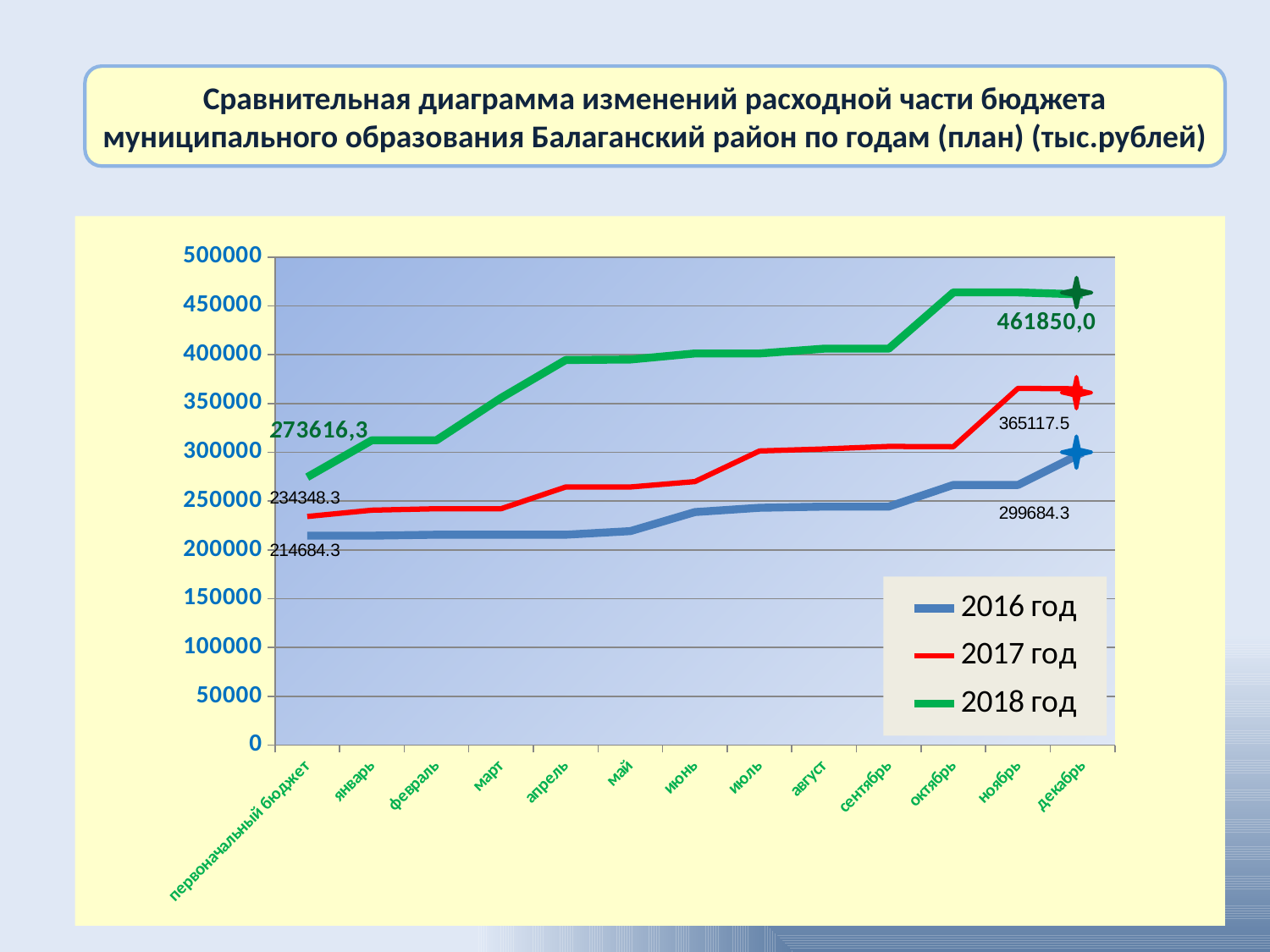
What is the difference between the 2016 год values at декабрь and at первоначальный бюджет? 85000.0 Which series has the lowest value at первоначальный бюджет? 2016 год What type of chart is shown on the slide? line chart Is the value for 2018 год at апрель greater or less than 350000? greater Do the values for 2018 год rise or fall from первоначальный бюджет to декабрь? rise What is the value for 2017 год at первоначальный бюджет? 234348.3 Which is larger at декабрь: the value for 2017 год or the value for 2016 год? 2017 год How many points are plotted along the x axis for each series? 13 What is the value for 2016 год at декабрь? 299684.3 How many series does the legend list? 3 What is the value for 2018 год at декабрь? 461850,0 Which series has the highest value at декабрь? 2018 год